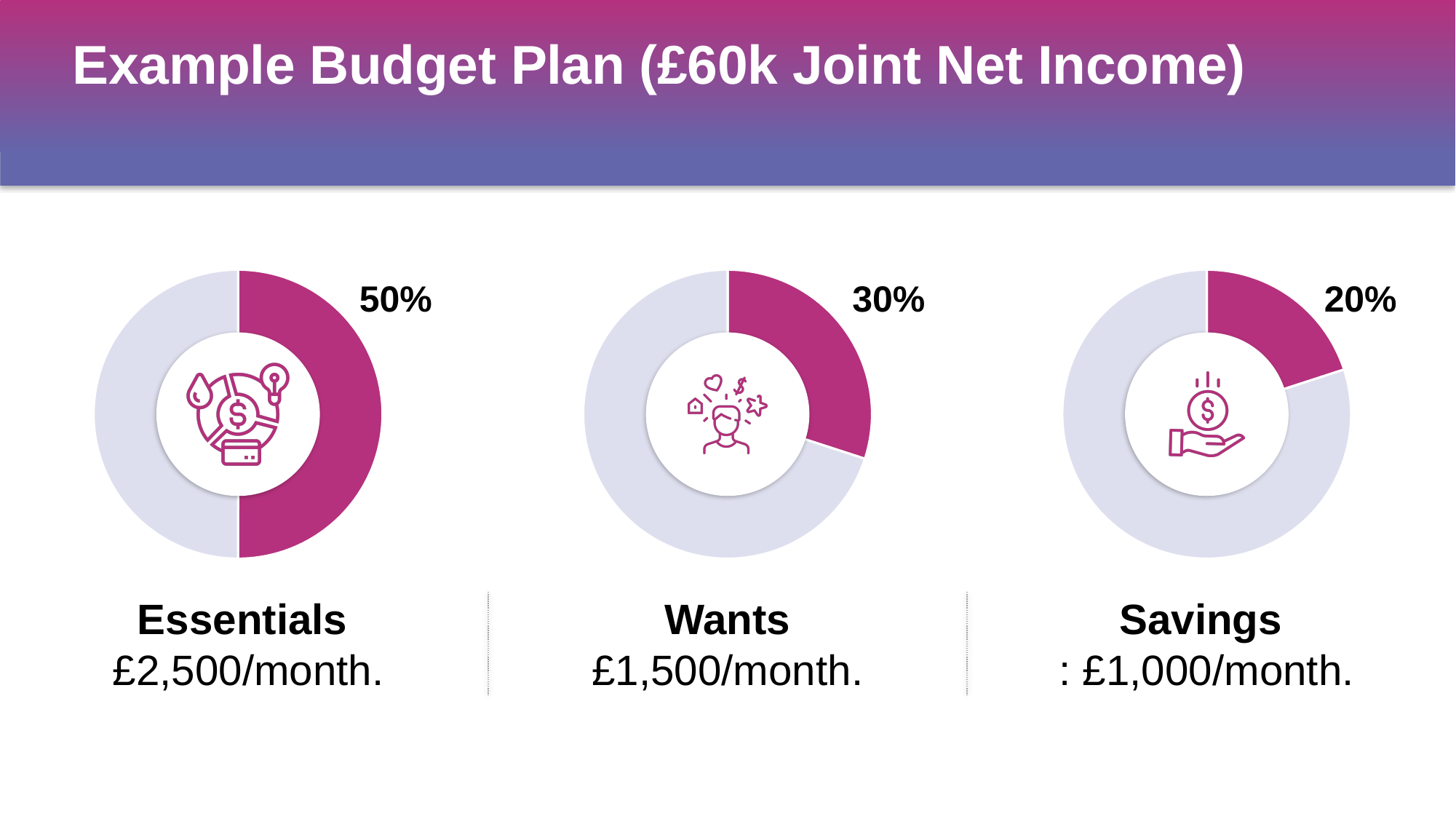
What type of chart is used for each budget category? Donut (pie) chart Which is larger, the Wants percentage or the Savings percentage? Wants What is the difference in percentage points between the Wants and Savings charts? 10 What is the difference in percentage points between the Essentials and Savings charts? 30 How many donut charts are shown on the slide? 3 Which of the three budget categories has the highest percentage? Essentials What percentage is shown on the Wants donut chart? 30% What percentage is shown on the Essentials donut chart? 50% What percentage is shown on the Savings donut chart? 20% Which of the three budget categories has the lowest percentage? Savings What is the title of the slide? Example Budget Plan (£60k Joint Net Income) What monthly amount is listed under the Wants chart? £1,500/month.